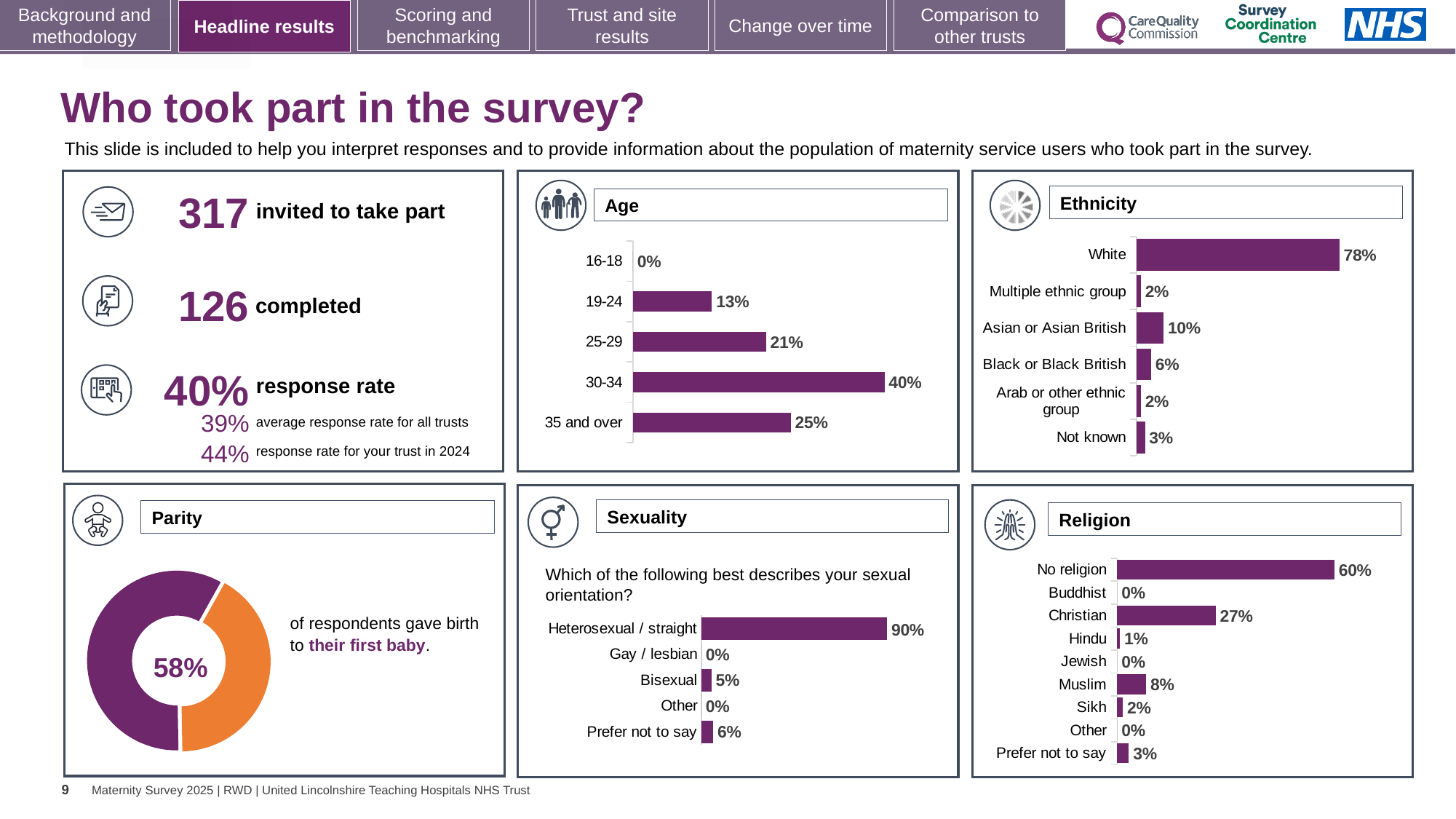
In the Religion chart, which category has the highest percentage? No religion In the Religion chart, how many categories are listed? 9 In the Age chart, how many age categories are shown? 5 In the Ethnicity chart, what is the difference between the percentages for Asian or Asian British and Black or Black British? 4% In the Sexuality chart, what percentage of respondents answered Heterosexual / straight? 90% In the Age chart, what percentage of respondents were aged 30-34? 40% In the Sexuality chart, what is the difference between Prefer not to say and Bisexual? 1% In the Age chart, which age group has the highest percentage? 30-34 In the Religion chart, what percentage of respondents were Christian? 27% What kind of chart is used in the Parity panel? Doughnut chart In the Ethnicity chart, what percentage of respondents were White? 78% In the Ethnicity chart, which is larger: Multiple ethnic group or Not known? Not known